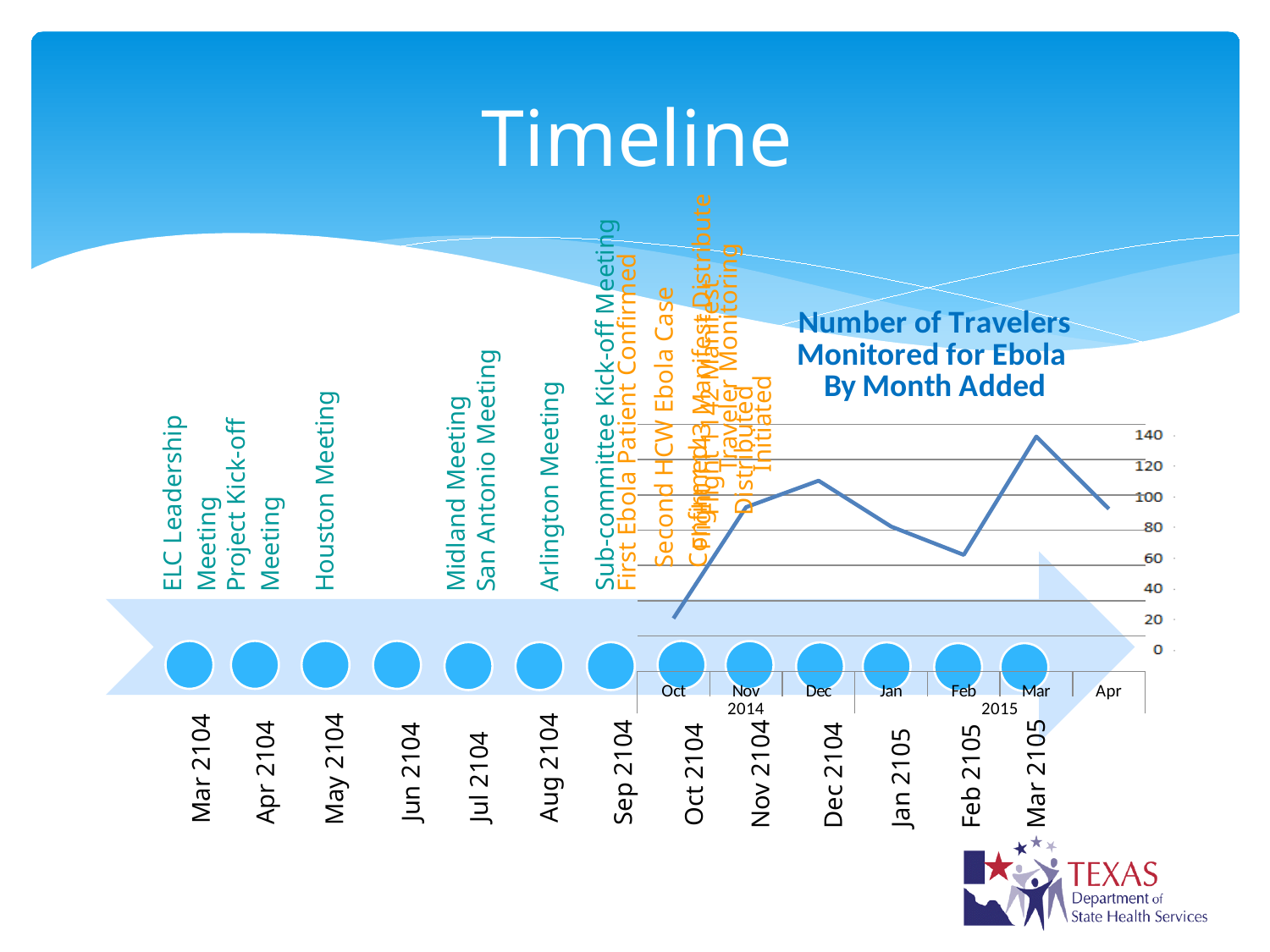
In the 'Number of Travelers Monitored for Ebola By Month Added' chart, which month has the lowest value? Oct What kind of chart is the 'Number of Travelers Monitored for Ebola By Month Added' chart? line chart In the 'Number of Travelers Monitored for Ebola By Month Added' chart, is the value for Feb greater or less than 80? less In the 'Number of Travelers Monitored for Ebola By Month Added' chart, which is larger, the value for Nov or the value for Feb? Nov In the 'Number of Travelers Monitored for Ebola By Month Added' chart, which is larger, the value for Dec or the value for Jan? Dec In the 'Number of Travelers Monitored for Ebola By Month Added' chart, is the value for Nov greater or less than 60? greater In the 'Number of Travelers Monitored for Ebola By Month Added' chart, which month has the highest value? Mar How many months are plotted on the x axis of the 'Number of Travelers Monitored for Ebola By Month Added' chart? 7 In the 'Number of Travelers Monitored for Ebola By Month Added' chart, is the value for Mar greater or less than 120? greater In the 'Number of Travelers Monitored for Ebola By Month Added' chart, do the values rise or fall from Dec to Feb? fall